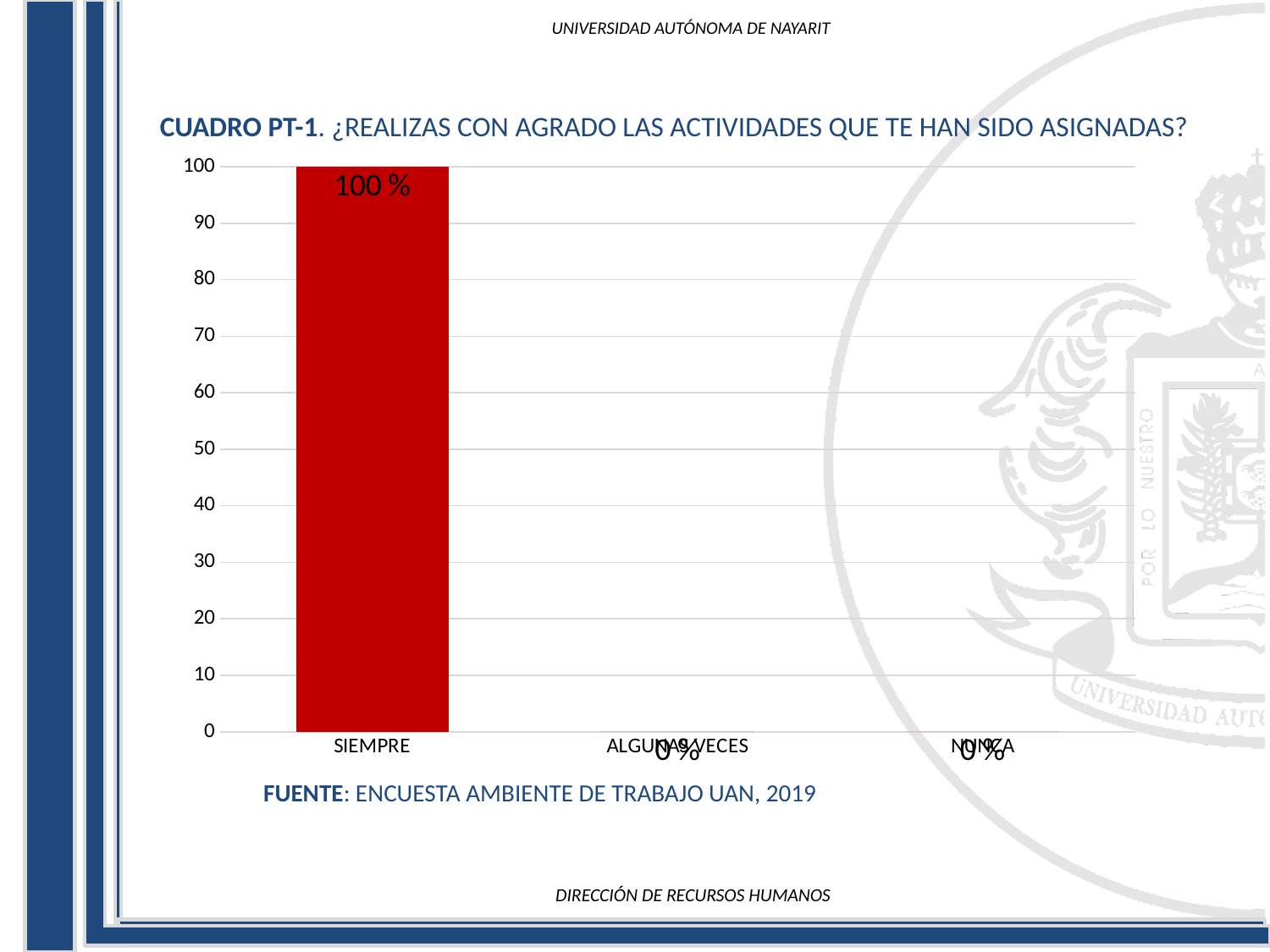
What is the source cited below the chart? ENCUESTA AMBIENTE DE TRABAJO UAN, 2019 What colour is the bar for SIEMPRE? red What is the value for SIEMPRE? 100 % Which is larger, the value for SIEMPRE or the value for ALGUNAS VECES? SIEMPRE Which category has the highest value? SIEMPRE What is the value for NUNCA? 0 % What kind of chart is shown on the slide? bar chart What is the value for ALGUNAS VECES? 0 % Do the values rise or fall from SIEMPRE to NUNCA along the x axis? fall How many categories are shown on the x axis? 3 What is the difference between the values for SIEMPRE and NUNCA? 100 % Is the value for SIEMPRE greater or less than 50? greater